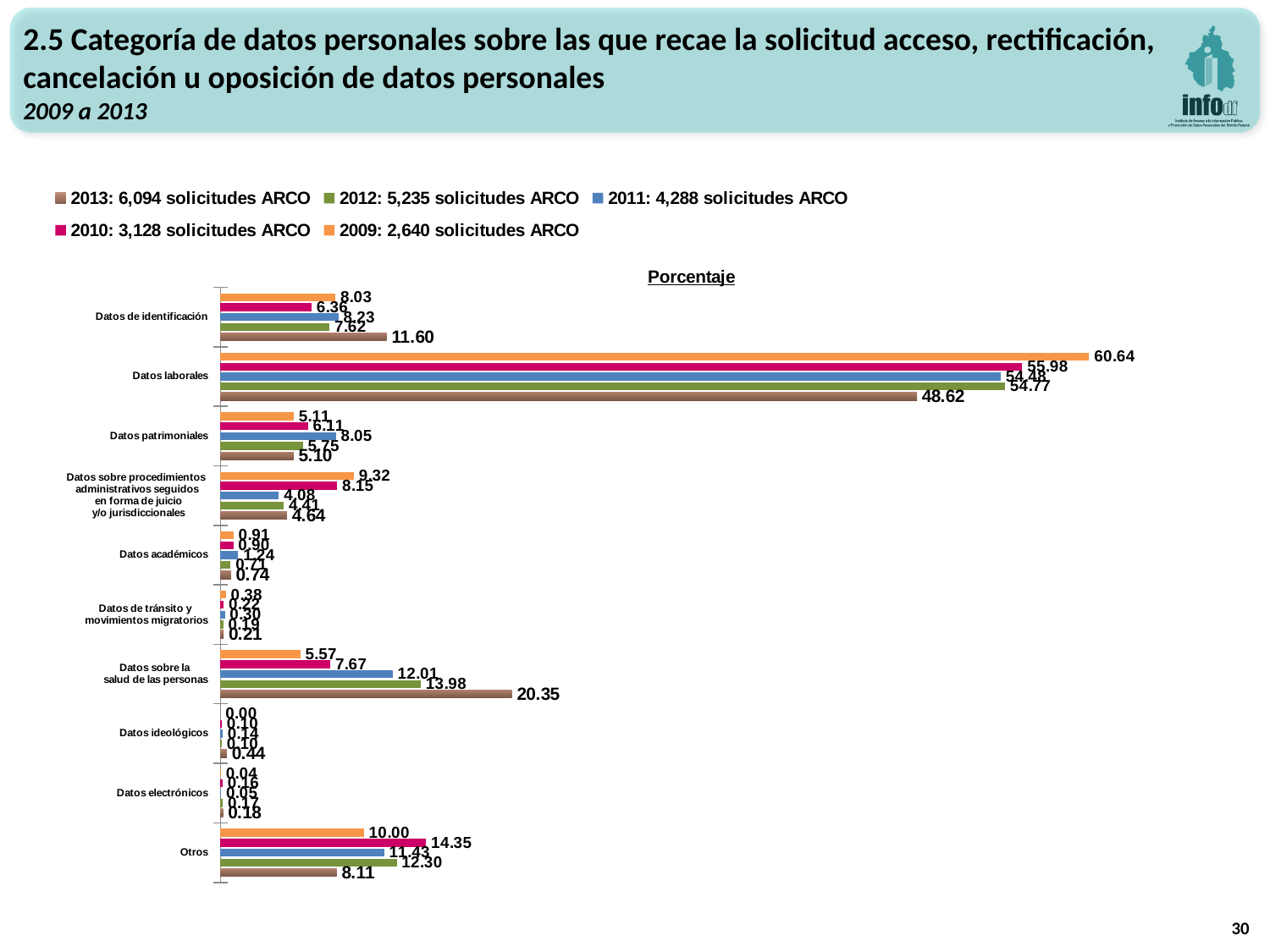
Which is larger for Datos sobre la salud de las personas, the 2012 value or the 2013 value? 2013 What is the 2010 percentage for Otros? 14.35 What is the difference between the 2009 and 2013 percentages for Datos laborales? 12.02 What is the difference between the 2013 and 2009 percentages for Datos sobre la salud de las personas? 14.78 How many categories of personal data are shown on the chart? 10 What is the 2013 percentage for Datos de identificación? 11.60 What is the 2013 percentage for Datos sobre la salud de las personas? 20.35 How many series does the legend list? 5 What kind of chart is shown on the slide? bar chart Which category has the highest percentage across all years? Datos laborales According to the legend, how many solicitudes ARCO were there in 2013? 6,094 What is the 2009 percentage for Datos laborales? 60.64